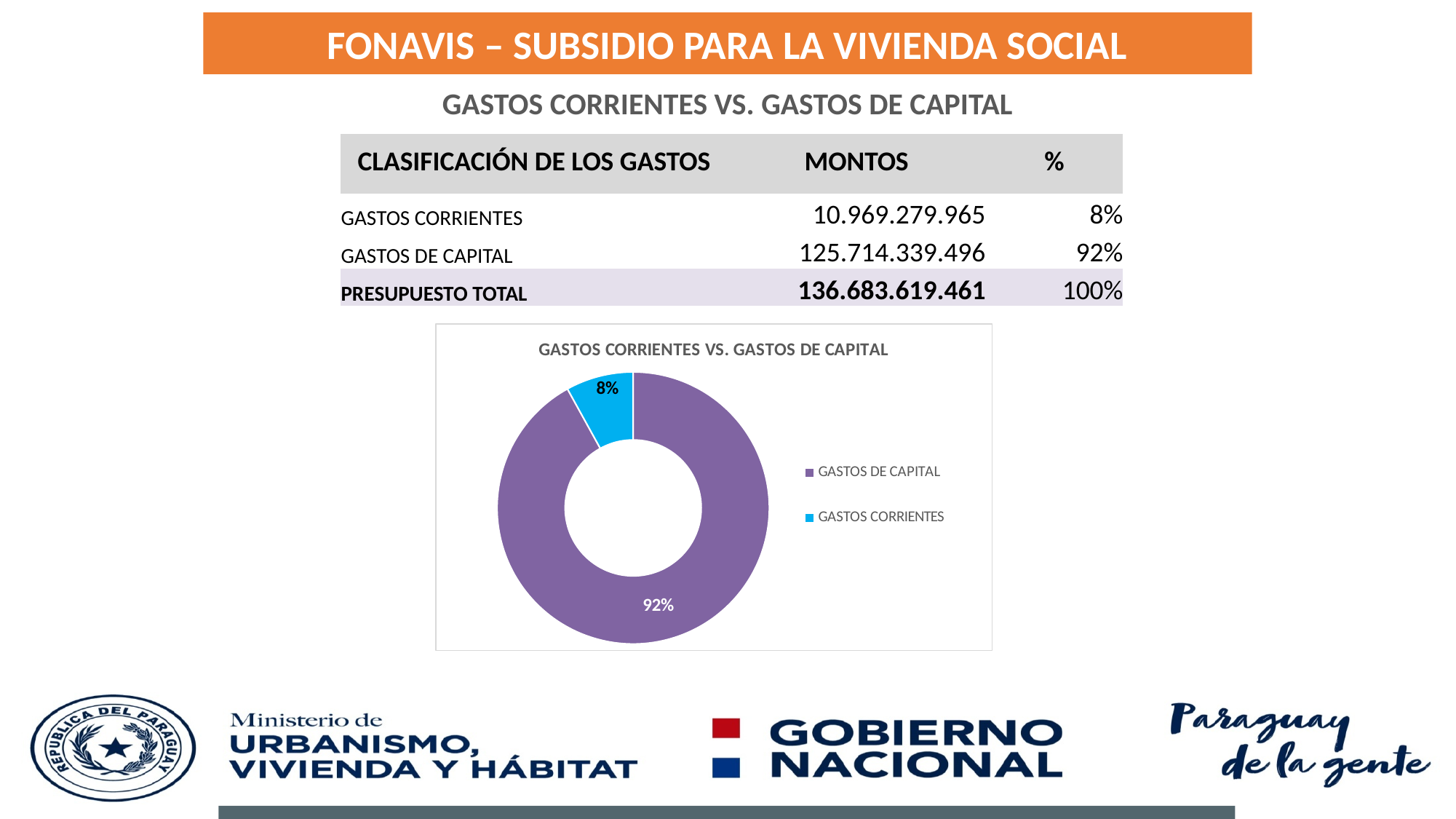
What percentage does the chart show for GASTOS DE CAPITAL? 92% What is the difference in percentage points between GASTOS DE CAPITAL and GASTOS CORRIENTES in the chart? 84 percentage points Which is larger in the chart, GASTOS CORRIENTES or GASTOS DE CAPITAL? GASTOS DE CAPITAL What percentage does the chart show for GASTOS CORRIENTES? 8% What is the title of the chart? GASTOS CORRIENTES VS. GASTOS DE CAPITAL Which category has the largest share in the chart? GASTOS DE CAPITAL Is the share for GASTOS DE CAPITAL greater or less than 50%? greater What colour represents GASTOS CORRIENTES in the chart? Light blue What kind of chart is shown on the slide? Doughnut chart Which category has the smallest share in the chart? GASTOS CORRIENTES How many categories does the chart's legend list? 2